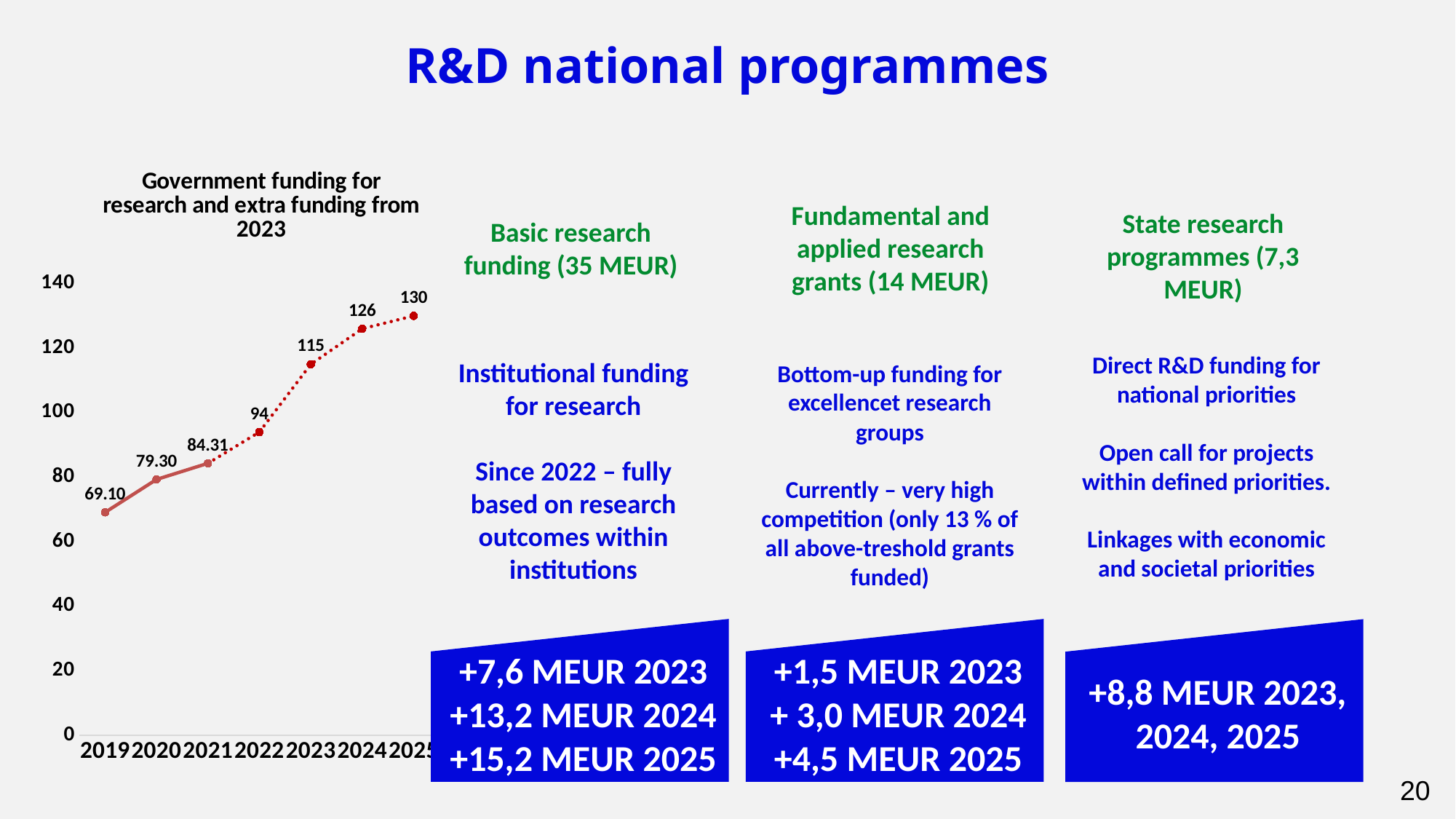
Which year has the highest value in the chart? 2025 Do the values rise or fall from 2019 to 2025? rise What is the value for 2019 in the chart? 69.10 What is the value for 2025 in the chart? 130 What kind of chart is shown on the slide? line chart What is the value for 2023 in the chart? 115 How many years are plotted in the chart? 7 What is the title of the chart? Government funding for research and extra funding from 2023 What is the value for 2021 in the chart? 84.31 What is the difference between the values for 2024 and 2023? 11 Which year has the lowest value in the chart? 2019 Which is larger, the value for 2020 or the value for 2022? 2022